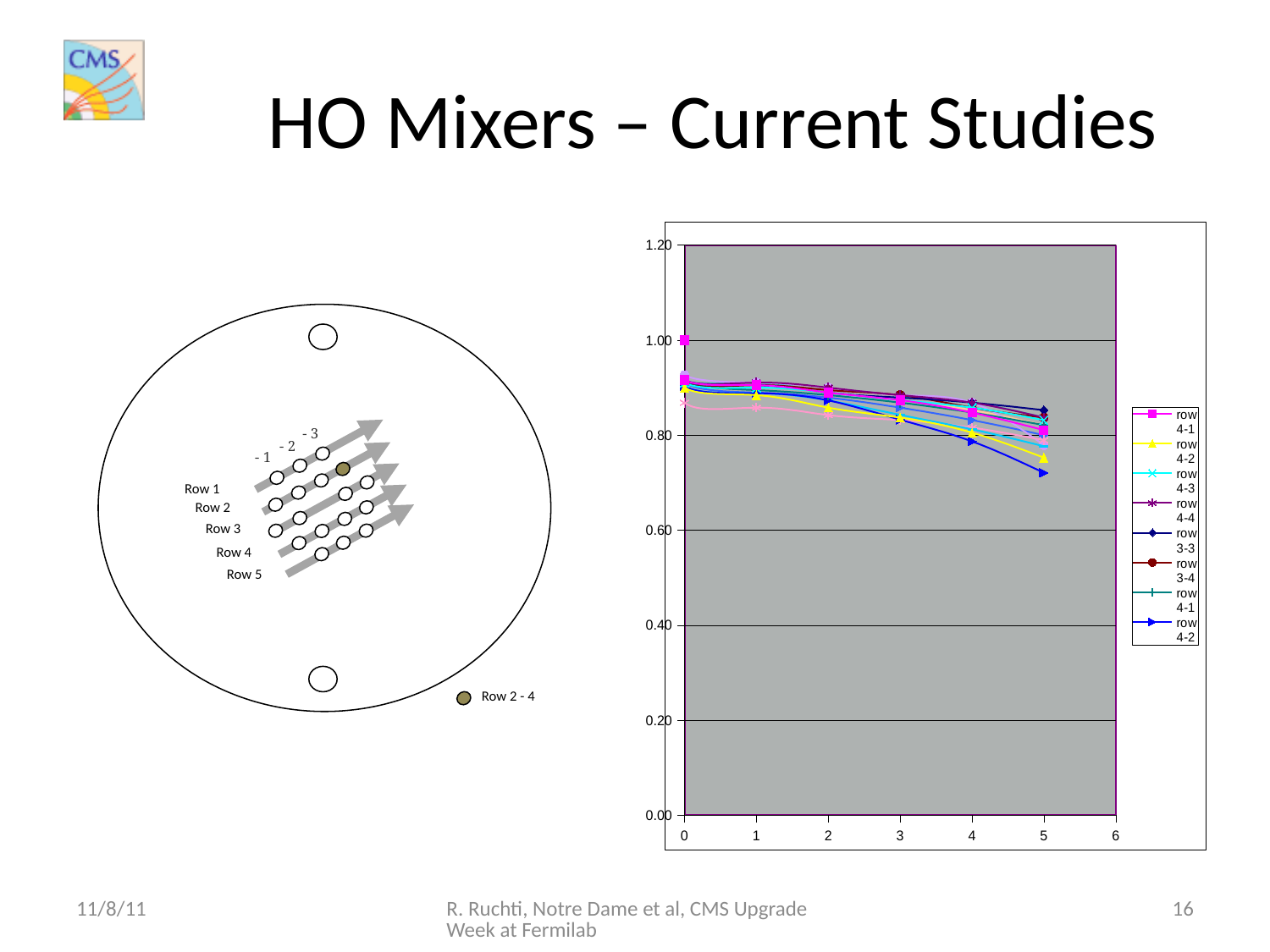
Do the plotted values generally rise or fall as x increases from 0 to 5? fall At x = 5, are all the plotted lines greater or less than 1.00? less At x = 3, is the highest line greater or less than 1.00? less At x = 5, is the lowest line greater or less than 0.80? less What is the maximum value shown on the y axis of the chart? 1.20 What kind of chart is shown on the right side of the slide? line chart How many series does the legend of the chart list? 8 How many tick labels are shown on the x axis of the chart? 7 What is the first entry listed in the chart's legend? row 4-1